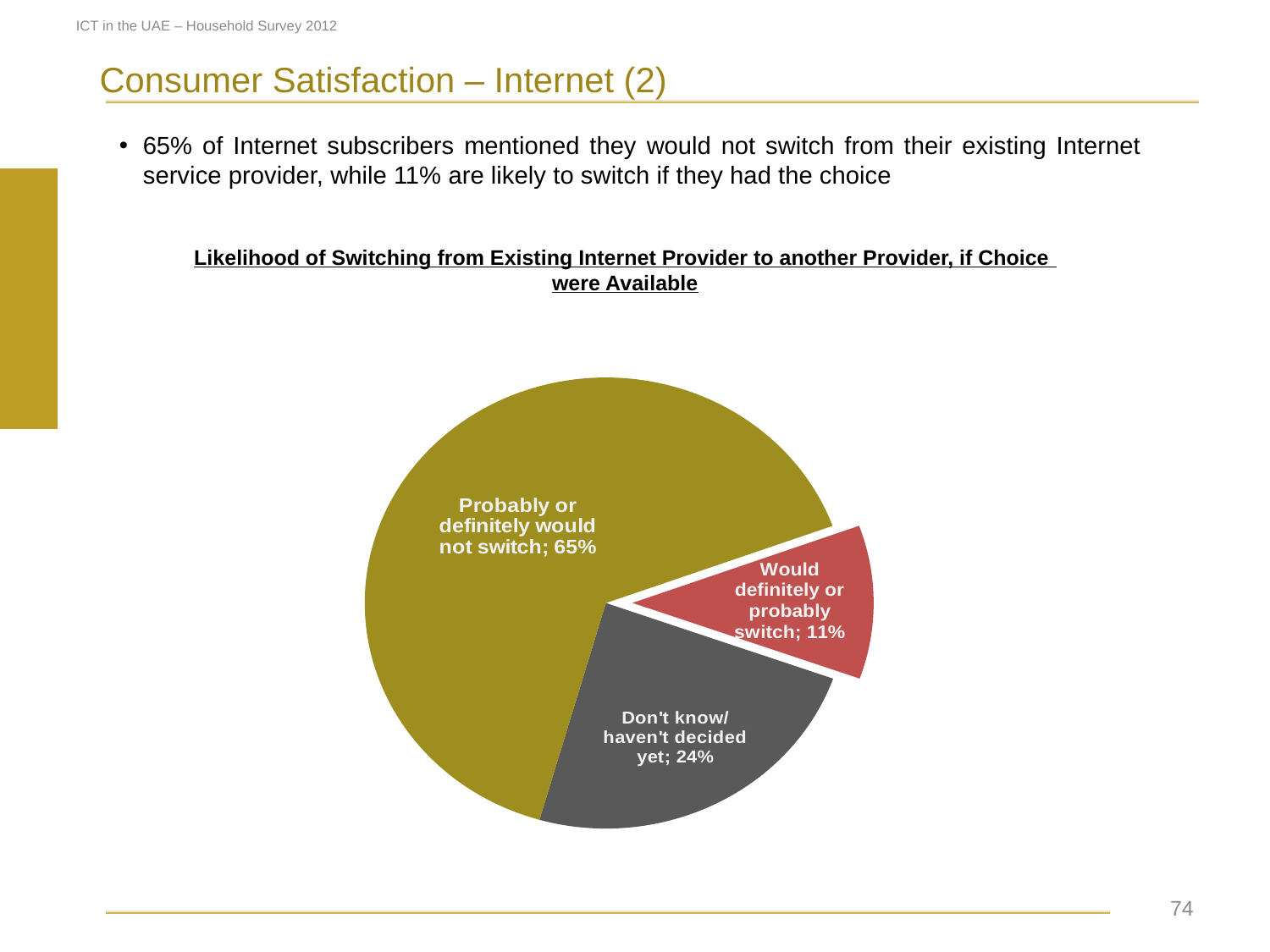
Which category has the smallest share of the pie? Would definitely or probably switch What type of chart is shown on the slide? Pie chart Which is larger: the share for 'Don't know/ haven't decided yet' or the share for 'Would definitely or probably switch'? Don't know/ haven't decided yet What is the difference in percentage points between 'Probably or definitely would not switch' and 'Don't know/ haven't decided yet'? 41 What is the difference in percentage points between 'Don't know/ haven't decided yet' and 'Would definitely or probably switch'? 13 How many slices does the pie chart have? 3 Which category has the largest share of the pie? Probably or definitely would not switch What is the title of the pie chart? Likelihood of Switching from Existing Internet Provider to another Provider, if Choice were Available What share of the pie is 'Would definitely or probably switch'? 11% What share of the pie is 'Probably or definitely would not switch'? 65% What share of the pie is 'Don't know/ haven't decided yet'? 24% What colour is the slice for 'Would definitely or probably switch'? Red